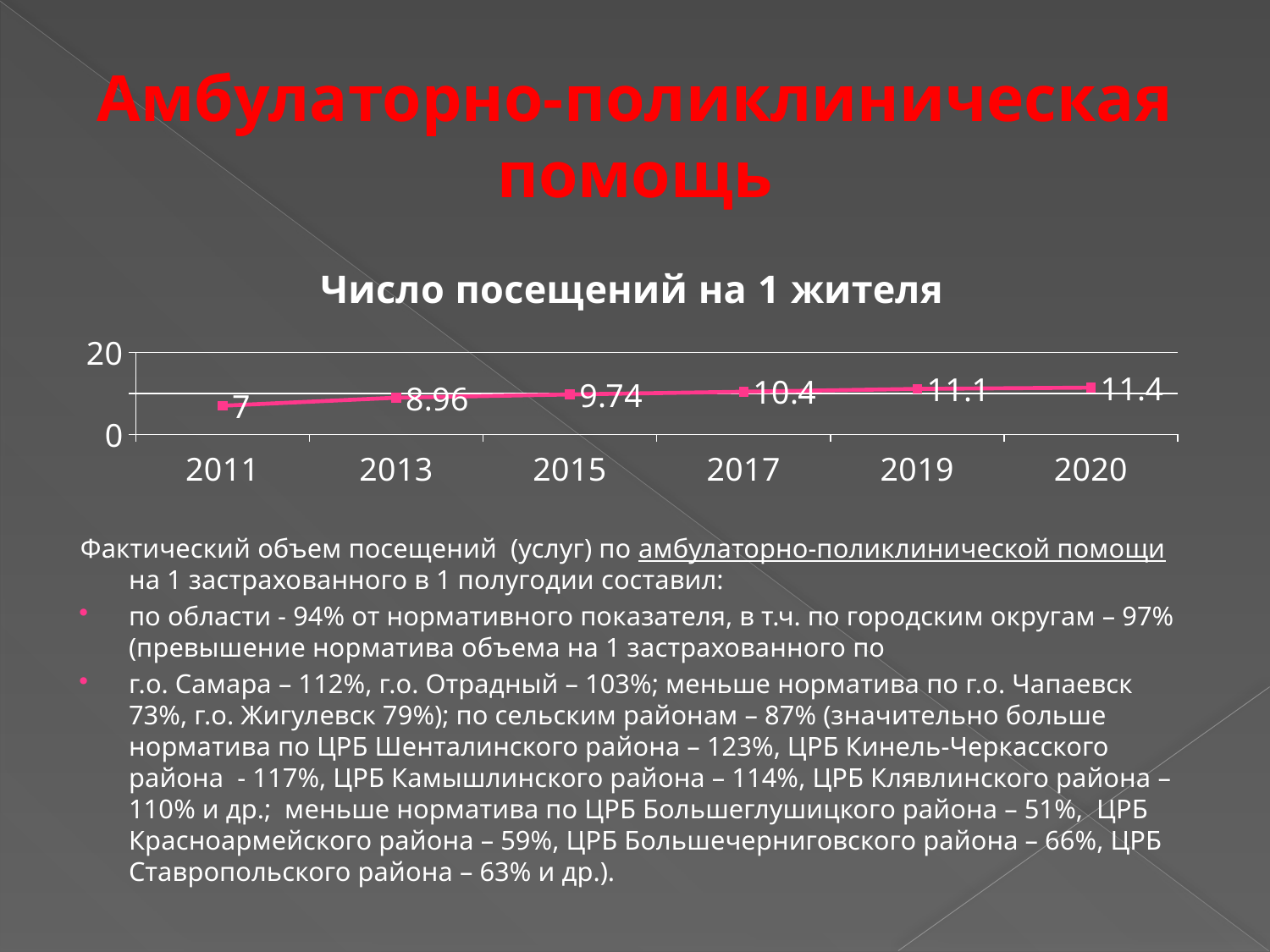
What is the value for 2013 in the chart? 8.96 What is the value for 2011 in the chart? 7 What is the title of the chart? Число посещений на 1 жителя What type of chart is shown on the slide? line chart Which is larger, the value for 2015 or the value for 2019? 2019 Which year has the highest value in the chart? 2020 How many data points are plotted in the chart? 6 Which year has the lowest value in the chart? 2011 What is the value for 2020 in the chart? 11.4 What is the value for 2017 in the chart? 10.4 What is the difference between the values for 2020 and 2011? 4.4 Do the values rise or fall from 2011 to 2020? rise